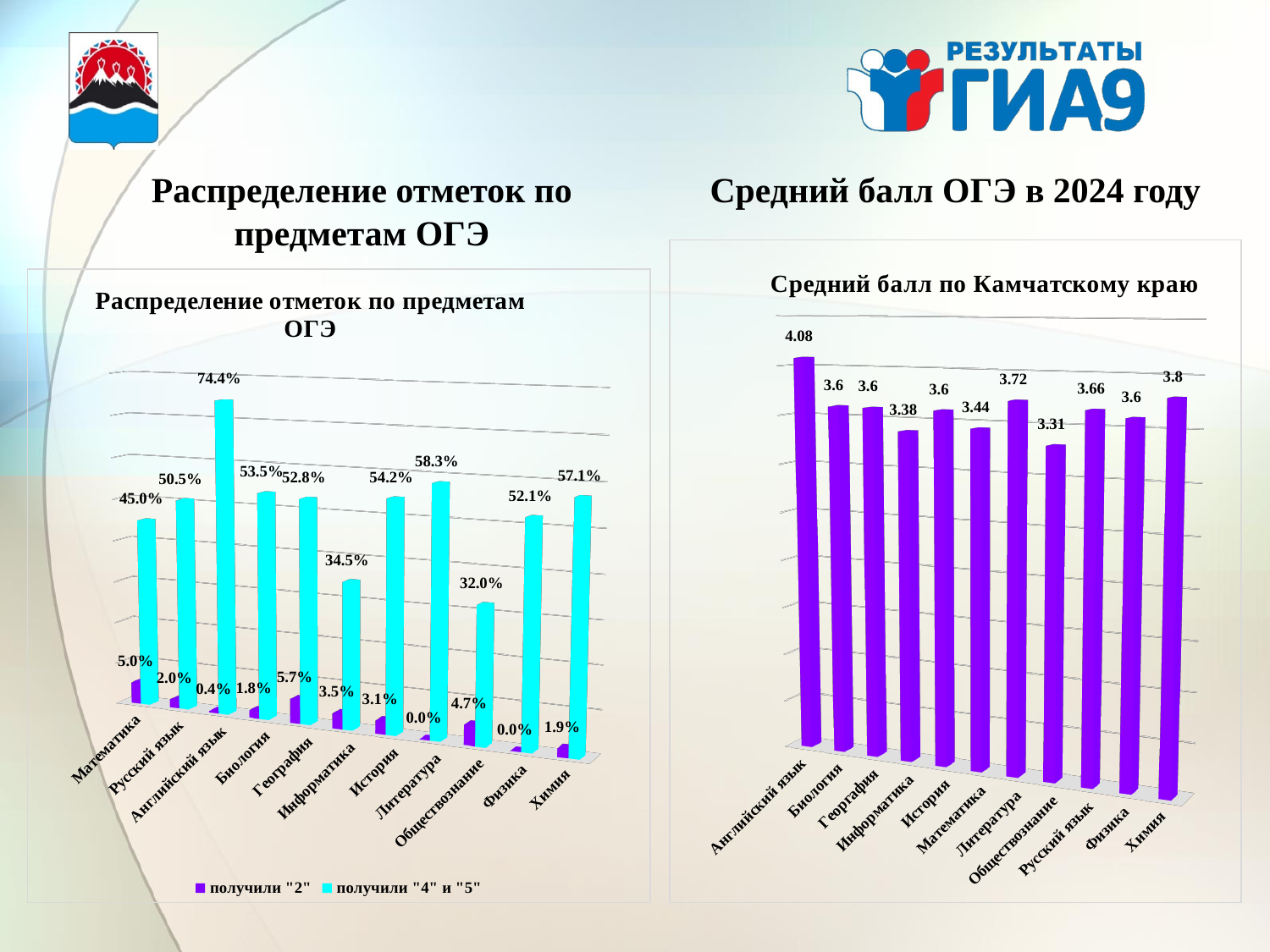
In the chart "Распределение отметок по предметам ОГЭ", what percentage of students received "2" in География? 5.7% In the chart "Распределение отметок по предметам ОГЭ", which subject has the lowest share of students who received "4" and "5"? Обществознание In the chart "Распределение отметок по предметам ОГЭ", what is the difference between the "4" and "5" shares for Литература and История? 4.1% What type of chart is "Средний балл по Камчатскому краю"? Bar chart In the chart "Средний балл по Камчатскому краю", how many subjects are shown? 11 In the chart "Средний балл по Камчатскому краю", which subject has the lowest average score? Обществознание In the chart "Средний балл по Камчатскому краю", what is the difference between the values for Химия and Информатика? 0.42 In the chart "Распределение отметок по предметам ОГЭ", what percentage of students received "4" and "5" in Английский язык? 74.4% How many series does the legend of the chart "Распределение отметок по предметам ОГЭ" list? 2 In the chart "Средний балл по Камчатскому краю", which is larger: the value for Литература or the value for Русский язык? Литература In the chart "Средний балл по Камчатскому краю", what is the value for Английский язык? 4.08 In the chart "Распределение отметок по предметам ОГЭ", which subject has the highest share of students who received "2"? География